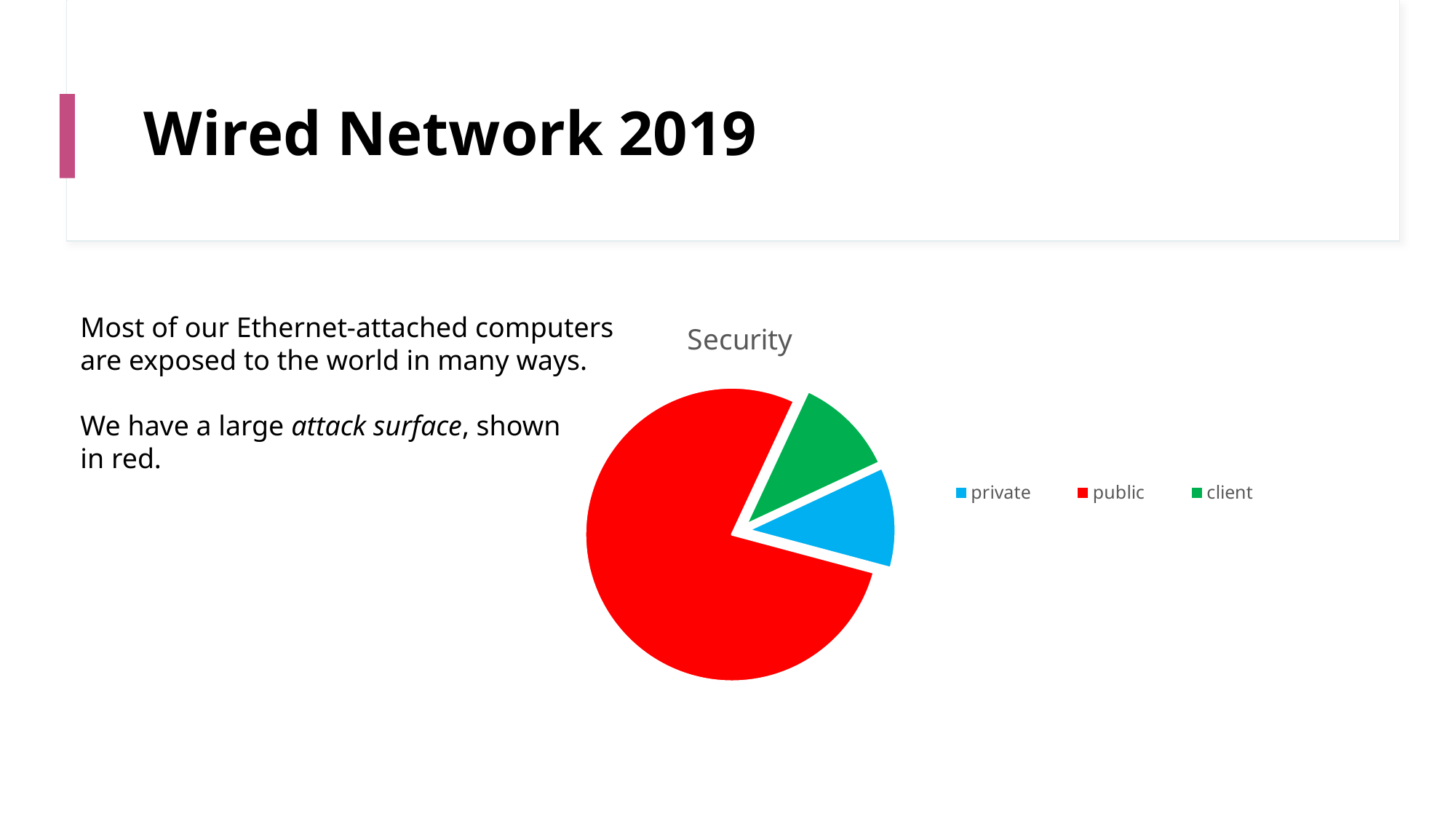
Which is larger, the public slice or the private slice? public Does the public slice account for more or less than half of the pie? more What colour is the public slice in the pie chart? red How many slices does the pie chart have? 3 How many entries does the chart legend list? 3 What kind of chart is shown on the slide? pie chart Which category has the largest slice of the pie? public What is the title of the chart? Security Which is larger, the client slice or the public slice? public